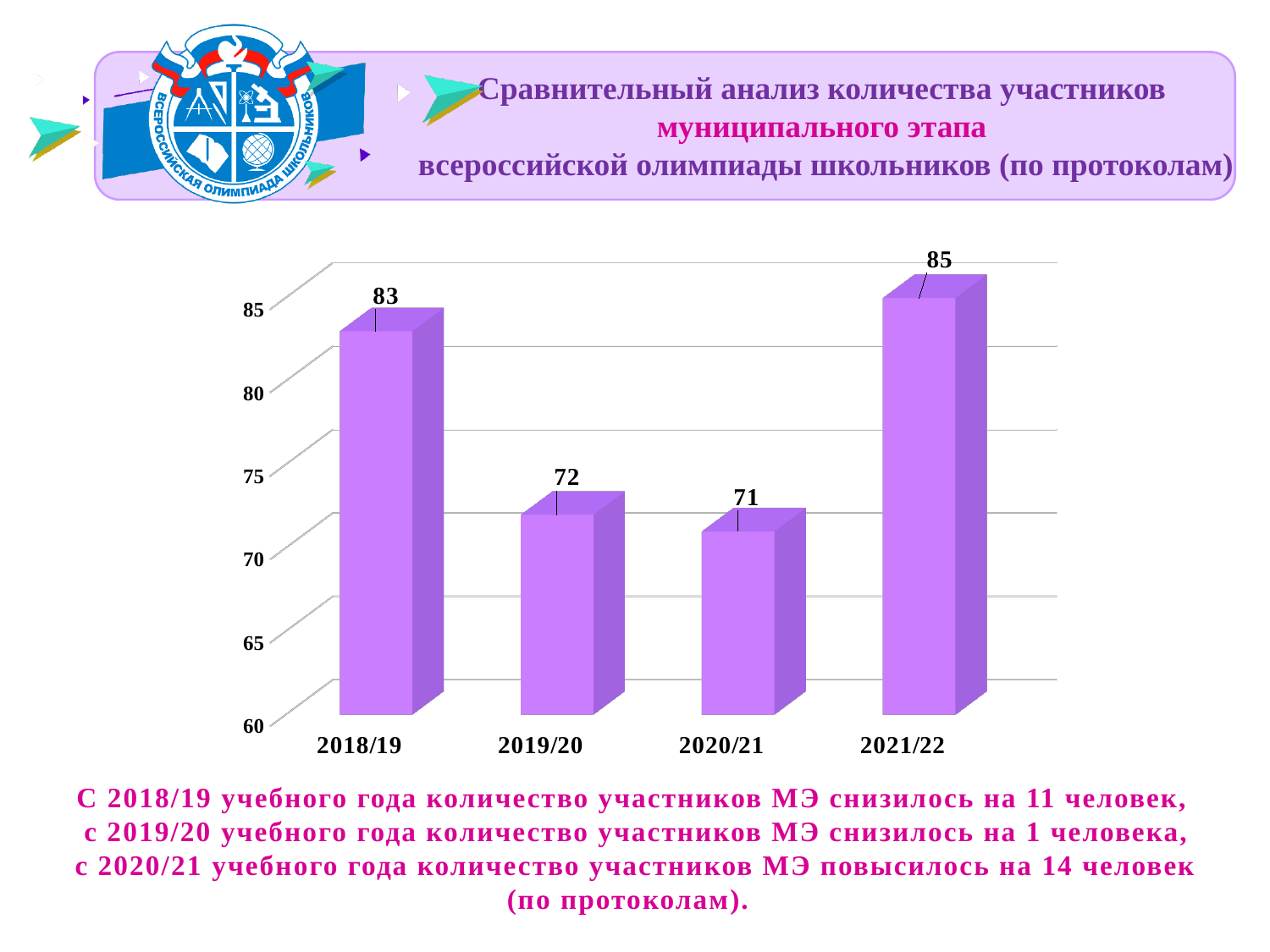
What is the value for 2018/19? 83 Which year has the highest value? 2021/22 Which is larger, the value for 2018/19 or the value for 2021/22? 2021/22 Is the value for 2019/20 greater or less than 75? less What is the value for 2020/21? 71 What is the value for 2021/22? 85 Which year has the lowest value? 2020/21 What is the value for 2019/20? 72 How many years are shown on the chart? 4 What kind of chart is shown on the slide? bar chart What is the difference between the values for 2021/22 and 2020/21? 14 What is the difference between the values for 2018/19 and 2019/20? 11